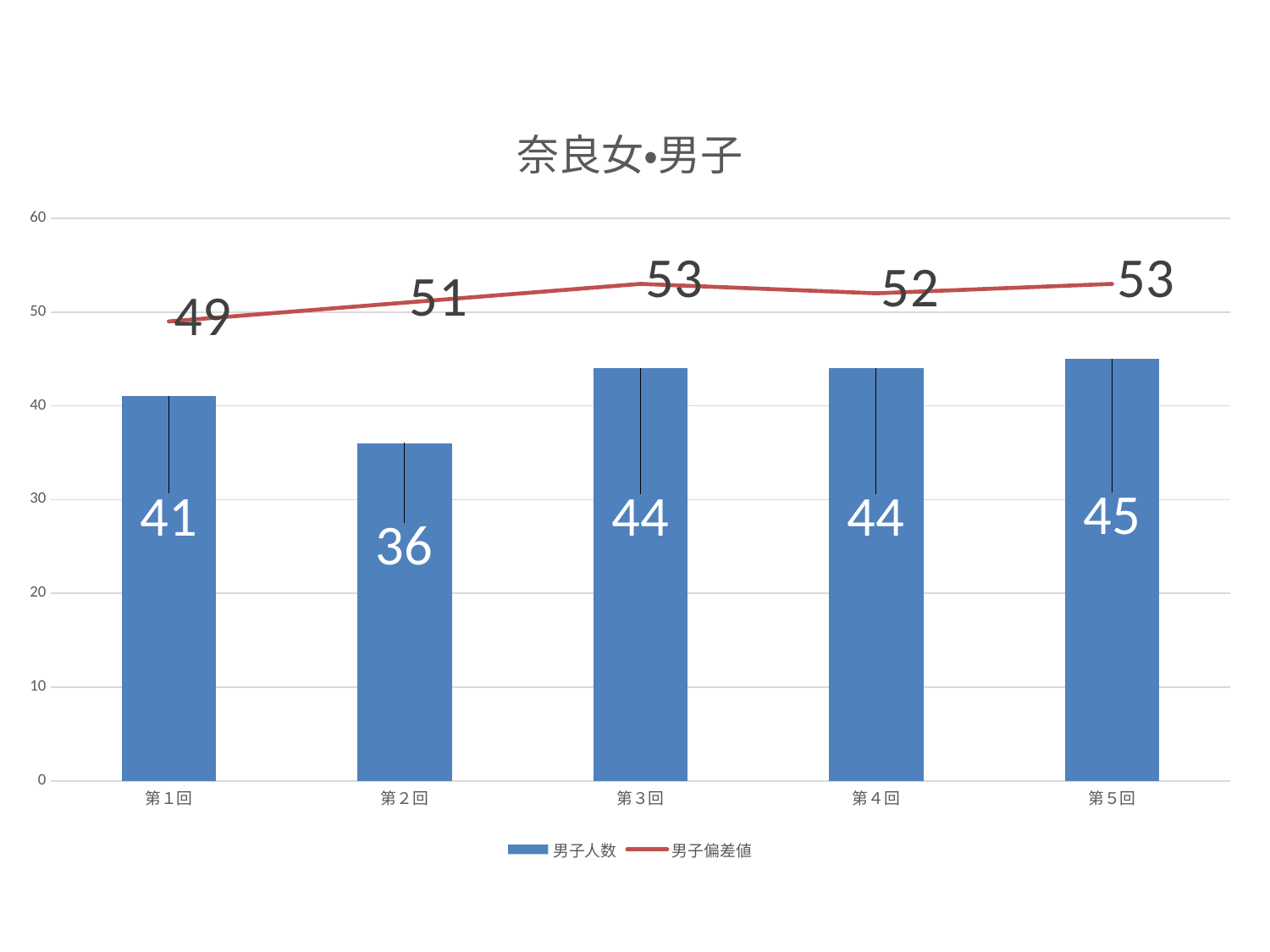
What kind of chart is this? Combined bar and line chart What is the value of 男子人数 for 第５回? 45 How many series does the legend list? 2 Which is larger, the 男子偏差値 for 第３回 or for 第１回? 第３回 How many categories are shown on the x axis? 5 What is the difference in 男子人数 between 第５回 and 第２回? 9 What is the value of 男子偏差値 for 第４回? 52 Which category has the lowest 男子偏差値? 第１回 Which category has the highest 男子人数? 第５回 Which category has the lowest 男子人数? 第２回 What is the value of 男子人数 for 第２回? 36 What is the title of the chart? 奈良女•男子